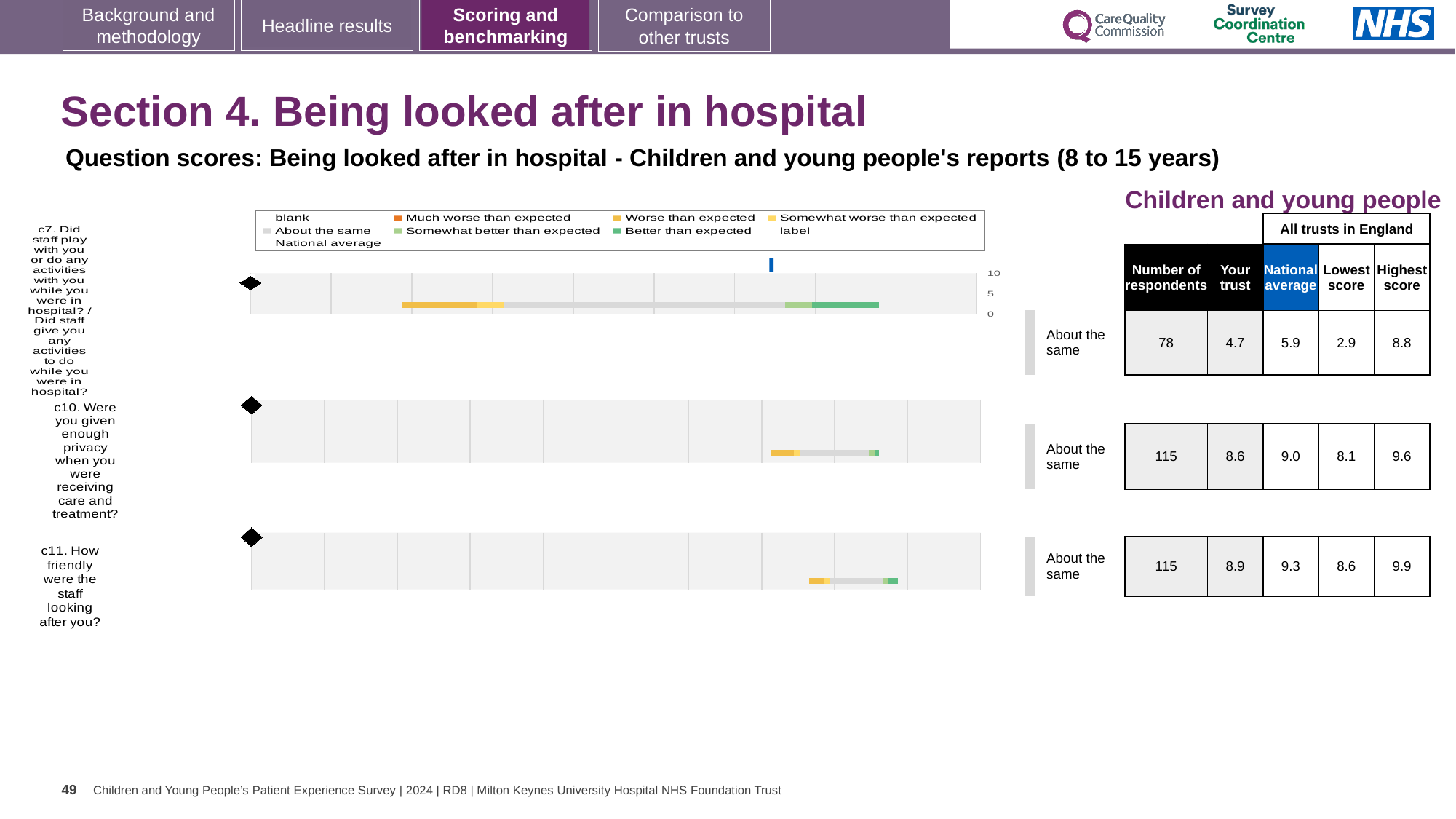
What is the national average score for question c11 (How friendly were the staff looking after you?)? 9.3 How many respondents answered question c7 (Did staff play with you or do any activities with you while you were in hospital?)? 78 For question c11, what is the difference between the highest score and the lowest score among all trusts in England? 1.3 For question c10, which is larger: the 'Your trust' score or the national average? National average What kind of chart is used to show the question scores on this slide? Bar chart For question c7, what is the difference between the national average and the 'Your trust' score? 1.2 Which question has the lowest 'Your trust' score? c7. Did staff play with you or do any activities with you while you were in hospital? What is the 'Your trust' score for question c10 (Were you given enough privacy when you were receiving care and treatment?)? 8.6 What benchmark label is shown next to the chart for question c7? About the same Which question has the highest 'Your trust' score? c11. How friendly were the staff looking after you? What is the highest score among all trusts in England for question c10? 9.6 How many survey questions are plotted on the slide? 3